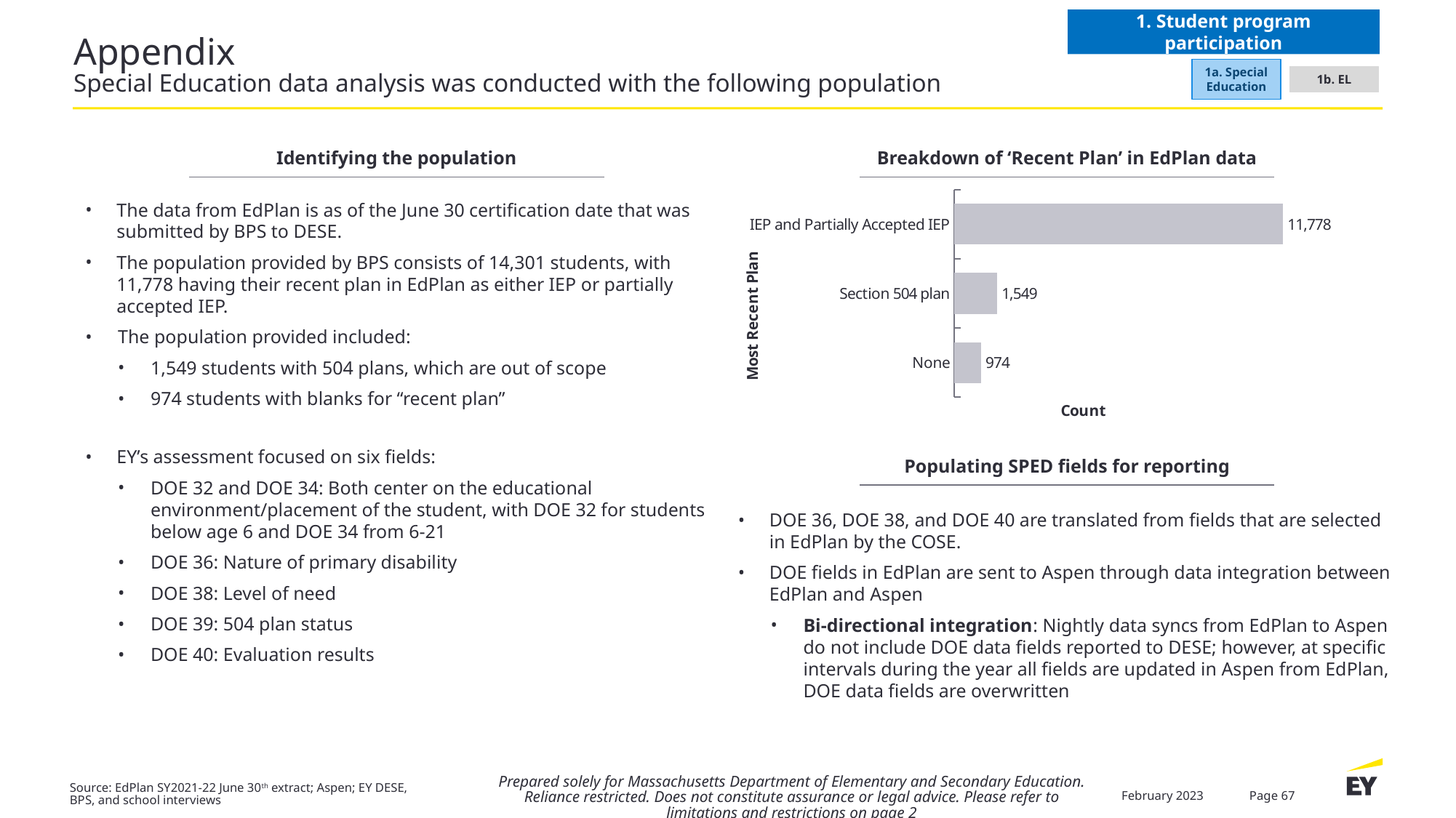
Which has a larger count, 'Section 504 plan' or 'None'? Section 504 plan What type of chart is shown on the slide? Bar chart What is the label of the horizontal axis of the chart? Count What is the count for 'IEP and Partially Accepted IEP' in the chart? 11,778 What is the count for 'None' in the chart? 974 What is the difference between the counts for 'Section 504 plan' and 'None'? 575 What is the difference between the counts for 'IEP and Partially Accepted IEP' and 'Section 504 plan'? 10,229 What is the count for 'Section 504 plan' in the chart? 1,549 Which category has the lowest count in the chart? None What is the title of the chart on the slide? Breakdown of 'Recent Plan' in EdPlan data How many categories are shown in the chart? 3 Which category has the highest count in the chart? IEP and Partially Accepted IEP